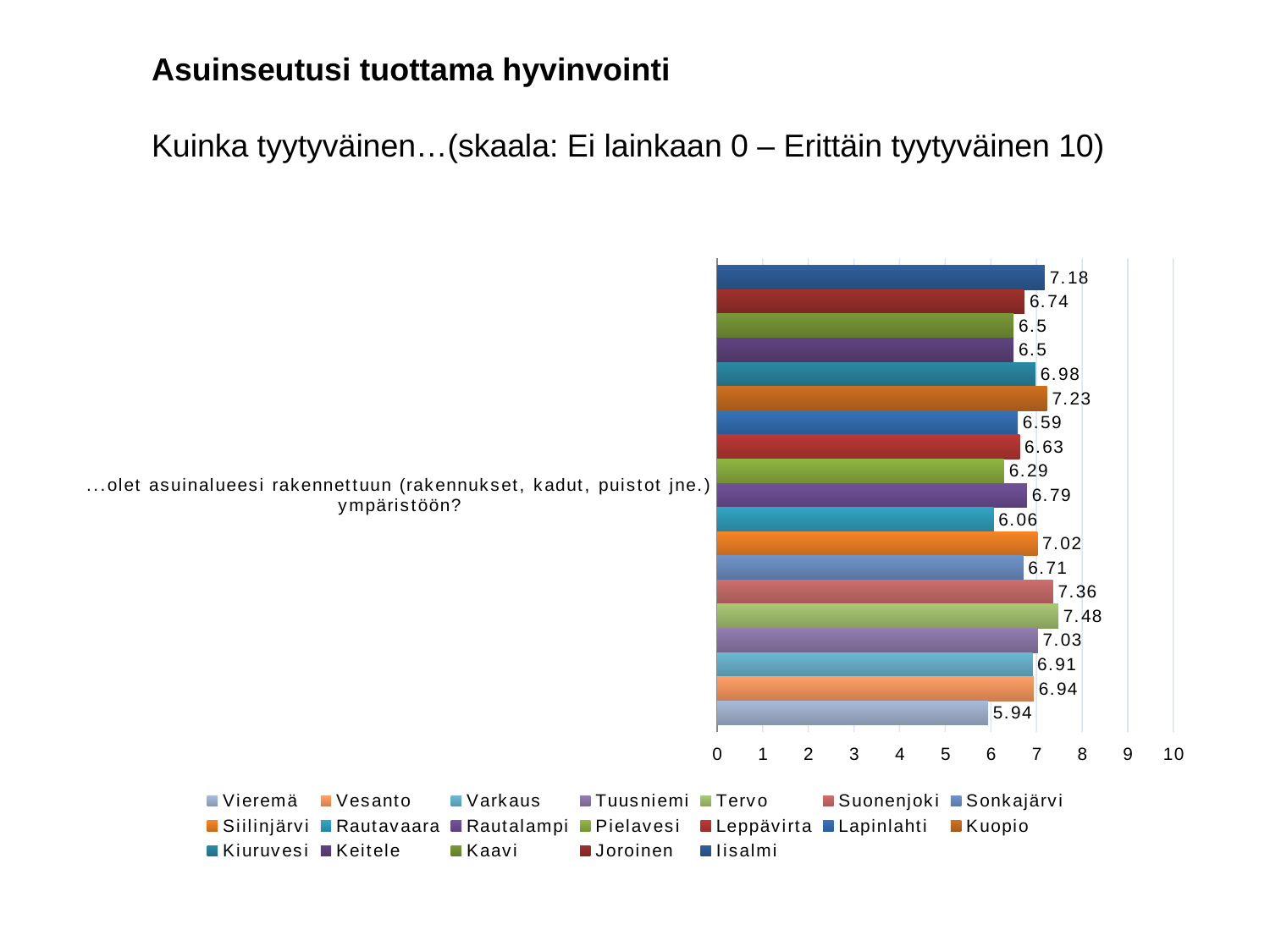
Which municipality has the lowest satisfaction value? Vieremä What is the value for Tervo? 7.48 How many series does the legend list? 19 What is the value for Vieremä? 5.94 Which municipality has the highest satisfaction value? Tervo What is the difference between the values for Tervo and Vieremä? 1.54 Which is larger, the value for Suonenjoki or the value for Rautavaara? Suonenjoki What is the value for Iisalmi? 7.18 How many categories are shown on the vertical axis of the chart? 1 What kind of chart is shown on the slide? bar chart What is the value for Kuopio? 7.23 Is the value for Pielavesi greater or less than 7? less